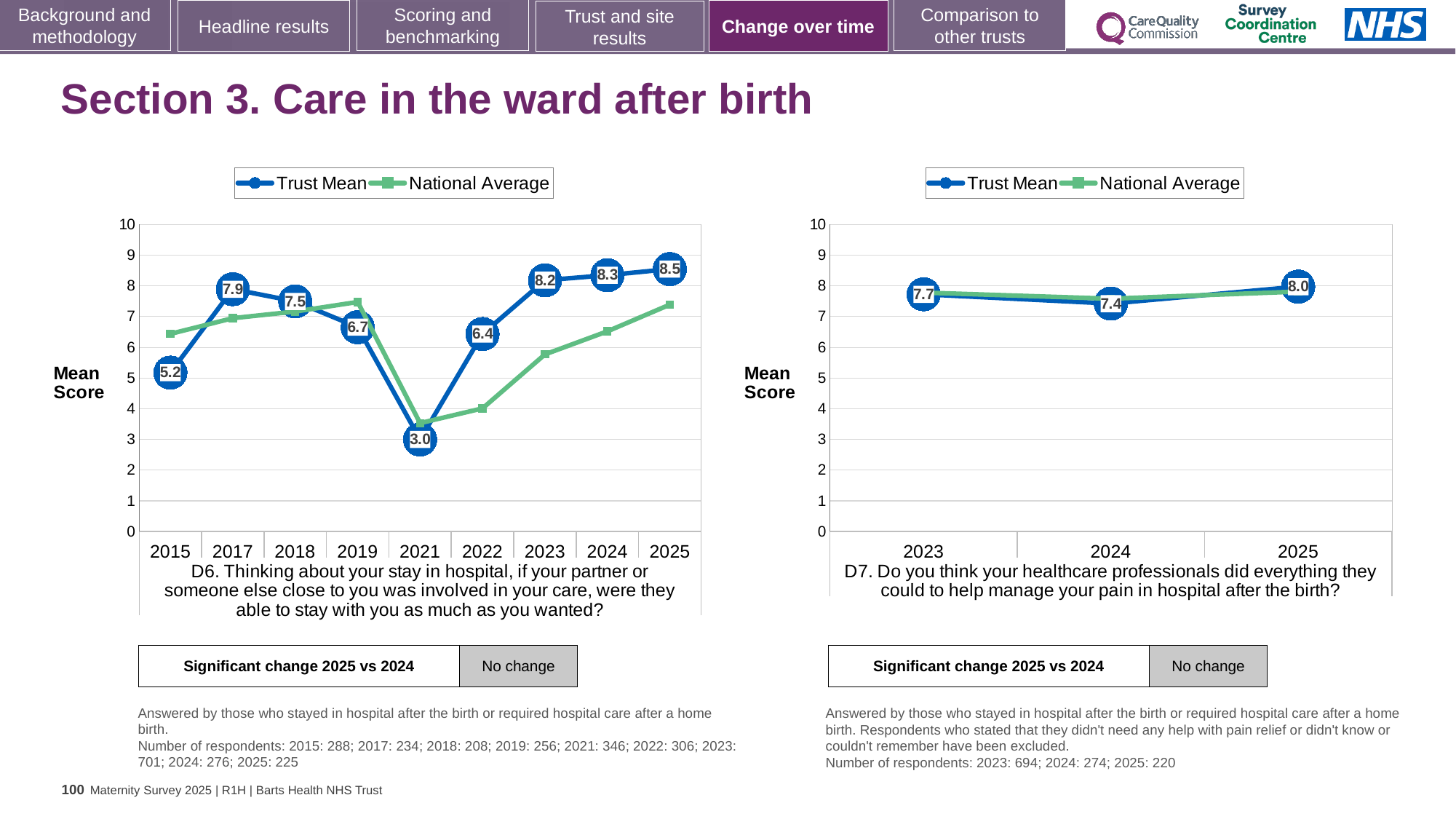
On the right chart (D7), how many series does the legend list? 2 On the left chart (D6), what is the Trust Mean score for 2025? 8.5 On the left chart (D6), what is the Trust Mean score for 2021? 3.0 On the left chart (D6), in which year is the Trust Mean highest? 2025 On the left chart (D6), is the Trust Mean higher in 2017 or in 2018? 2017 On the left chart (D6), how many years are shown on the x axis? 9 On the left chart (D6), is the National Average for 2022 greater or less than 5? less On the right chart (D7), what is the Trust Mean score for 2024? 7.4 On the right chart (D7), what is the difference between the Trust Mean in 2025 and in 2024? 0.6 On the left chart (D6), in which year is the Trust Mean lowest? 2021 What kind of chart is the right chart (D7)? Line chart On the left chart (D6), what is the difference between the Trust Mean in 2025 and in 2021? 5.5